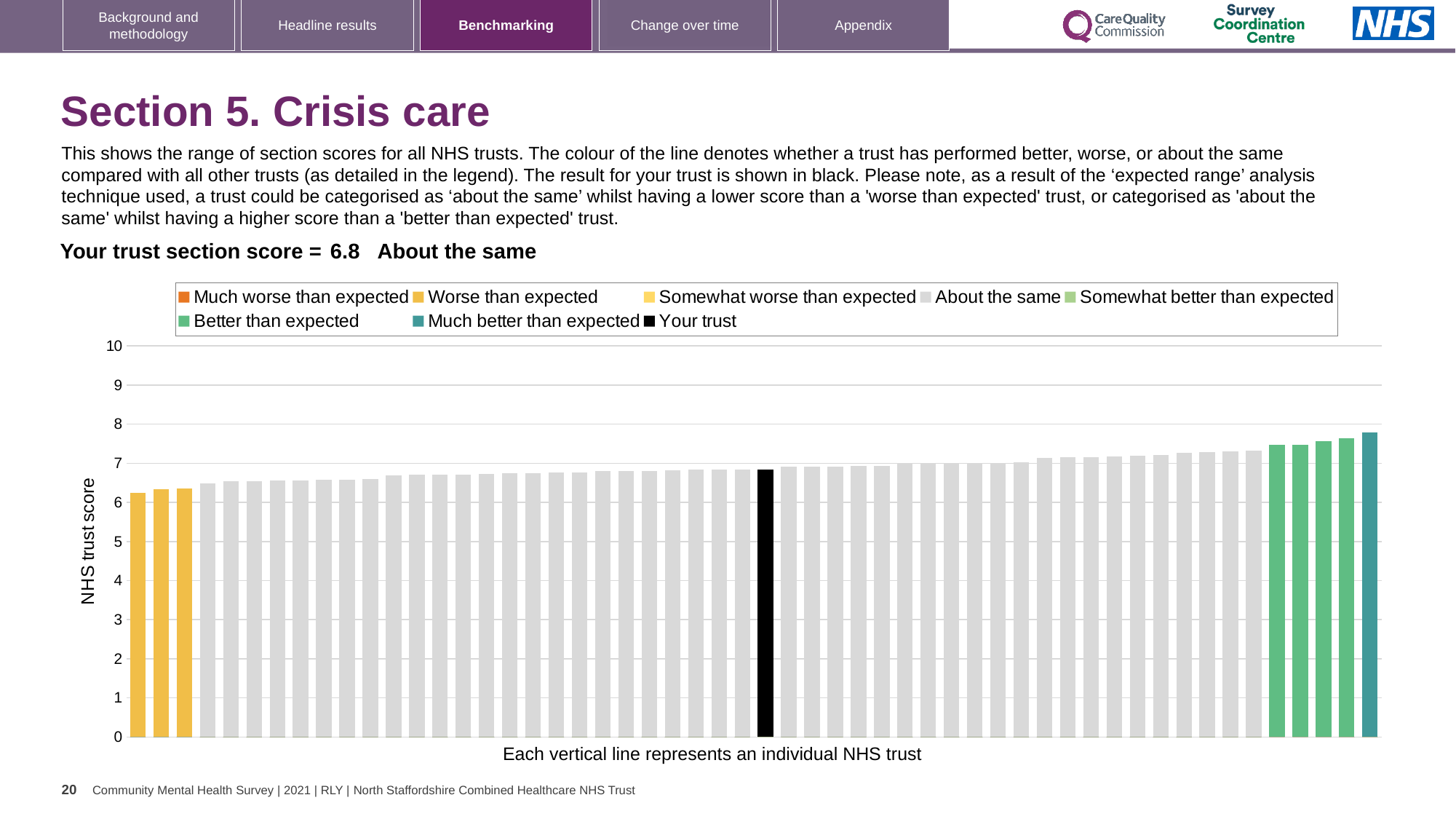
Which is larger: the value for your trust (black bar) or the value of the rightmost bar? the rightmost bar What kind of chart is shown on the slide? bar chart Which category is your trust placed in for this section? About the same How many bars are coloured as 'Worse than expected' (yellow)? 3 What is the label on the vertical axis of the chart? NHS trust score Is the value of the leftmost bar on the chart less or greater than 7? less How many bars are coloured as 'Better than expected' (green)? 4 Do the bar values rise or fall from left to right along the x axis? rise Is the value for your trust (the black bar) greater or less than 5? greater Is the value of the tallest bar on the chart greater or less than 7? greater What is the section score for your trust shown on the slide? 6.8 How many entries does the chart legend list? 8